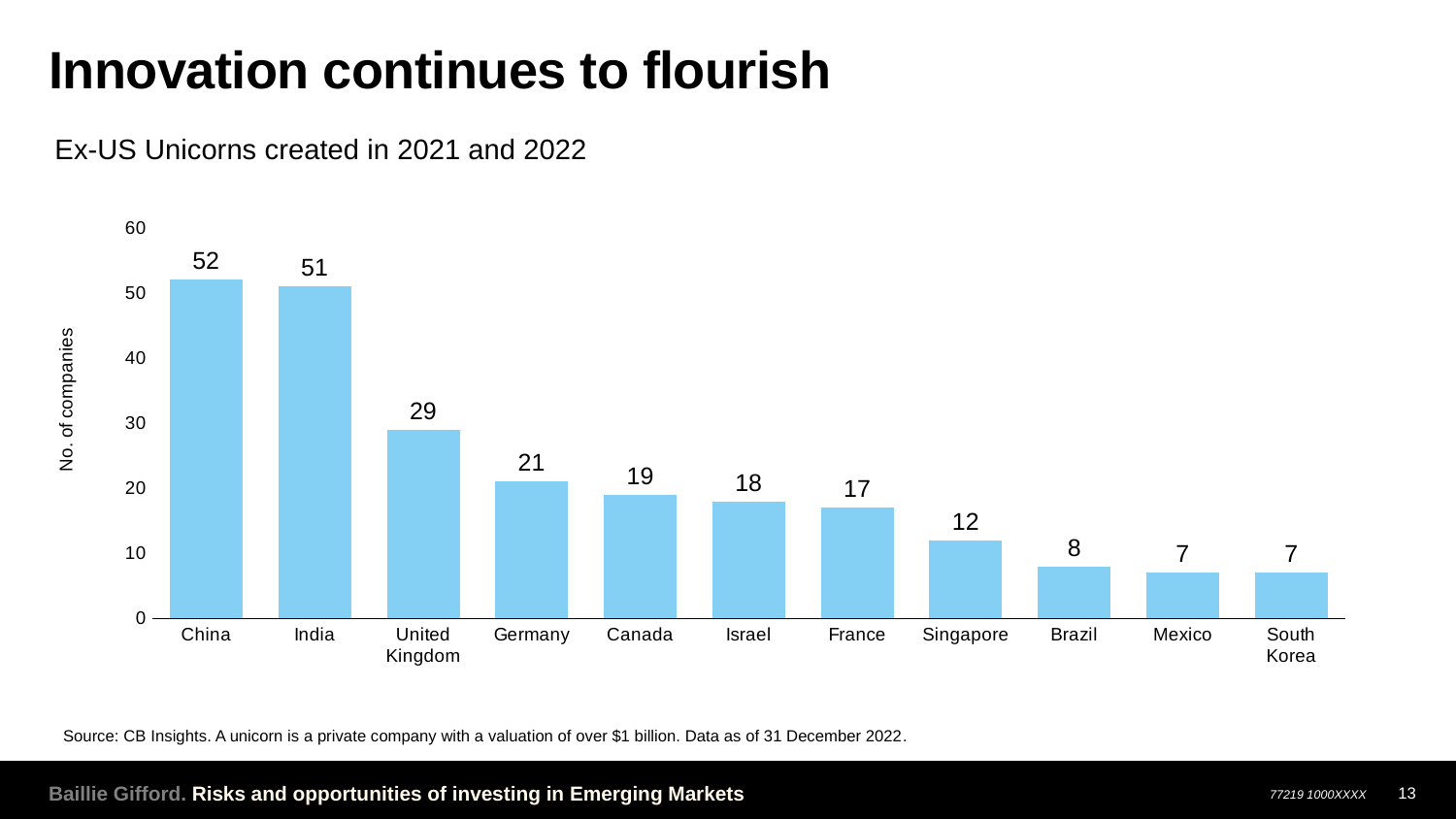
What is the value shown for the United Kingdom? 29 What is the difference between the values for China and India? 1 How many countries are shown on the chart? 11 How many companies are shown for Singapore? 12 Do the values rise or fall moving from left to right along the x axis? Fall What is the label on the vertical axis of the chart? No. of companies What is the difference between the values for the United Kingdom and Germany? 8 What kind of chart is shown on the slide? Bar chart Which country has the lowest value on the chart, Brazil or Mexico? Mexico How many ex-US unicorns were created in China in 2021 and 2022? 52 Which has a larger value, Canada or Israel? Canada Which country has the highest number of unicorns created? China